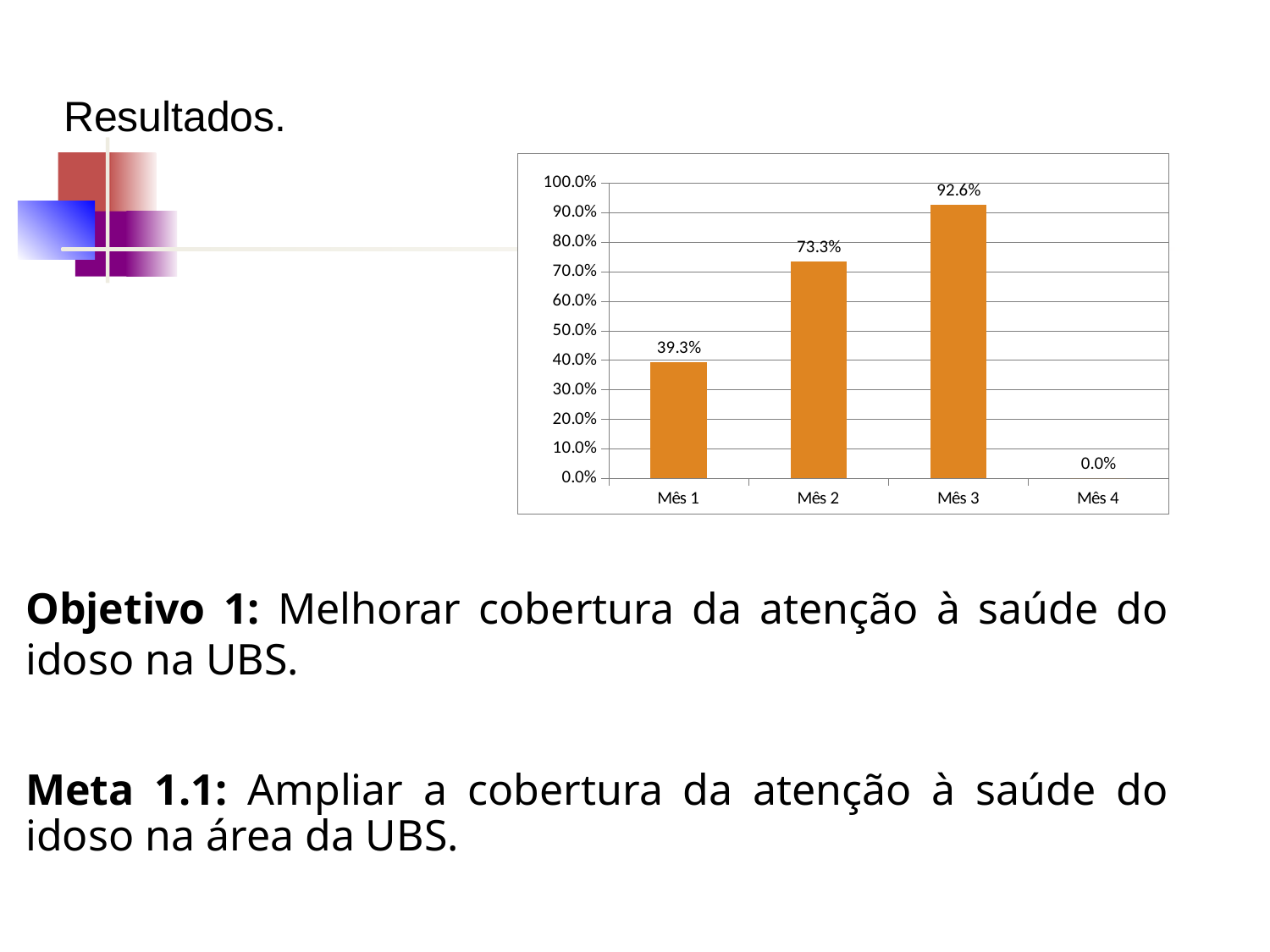
Which category has the lowest value? Mês 4 What kind of chart is shown on the slide? bar chart Which is larger, the value for Mês 1 or the value for Mês 2? Mês 2 What is the difference between the values for Mês 3 and Mês 2? 19.3% What is the difference between the values for Mês 2 and Mês 1? 34.0% Which category has the highest value? Mês 3 What is the value for Mês 4? 0.0% What is the value for Mês 1? 39.3% How many categories are shown on the x axis? 4 What is the value for Mês 3? 92.6% What is the value for Mês 2? 73.3% Is the value for Mês 3 greater or less than 90.0%? greater